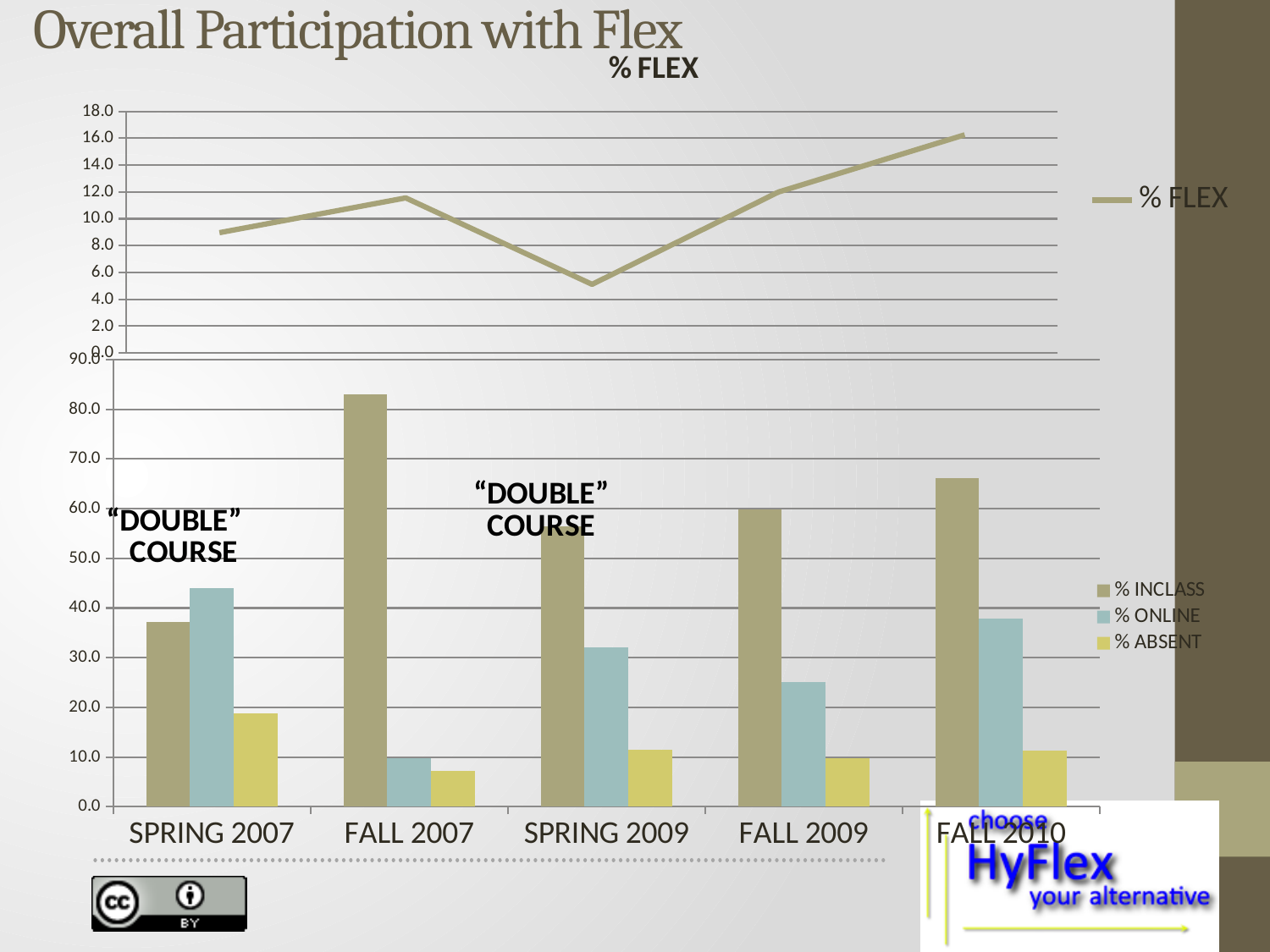
What kind of chart is the bottom chart with the semester categories? bar chart In the top "% FLEX" line chart, is the lowest point on the line greater or less than 6.0? less In the bottom bar chart, which semester has the lowest % INCLASS value? SPRING 2007 In the bottom bar chart, how many series does the legend list? 3 In the bottom bar chart, which semester has the highest % INCLASS value? FALL 2007 In the bottom bar chart, for SPRING 2007, which is larger: % INCLASS or % ONLINE? % ONLINE In the bottom bar chart, is the % ABSENT value for FALL 2007 greater or less than 10.0? less In the bottom bar chart, is the % INCLASS value for FALL 2007 greater or less than 80.0? greater In the top "% FLEX" line chart, does the line rise or fall from its fourth point to its last point? rise In the bottom bar chart, how many semester categories are shown on the x axis? 5 What kind of chart is the top chart titled "% FLEX"? line chart In the bottom bar chart, which semester has the highest % ONLINE value? SPRING 2007